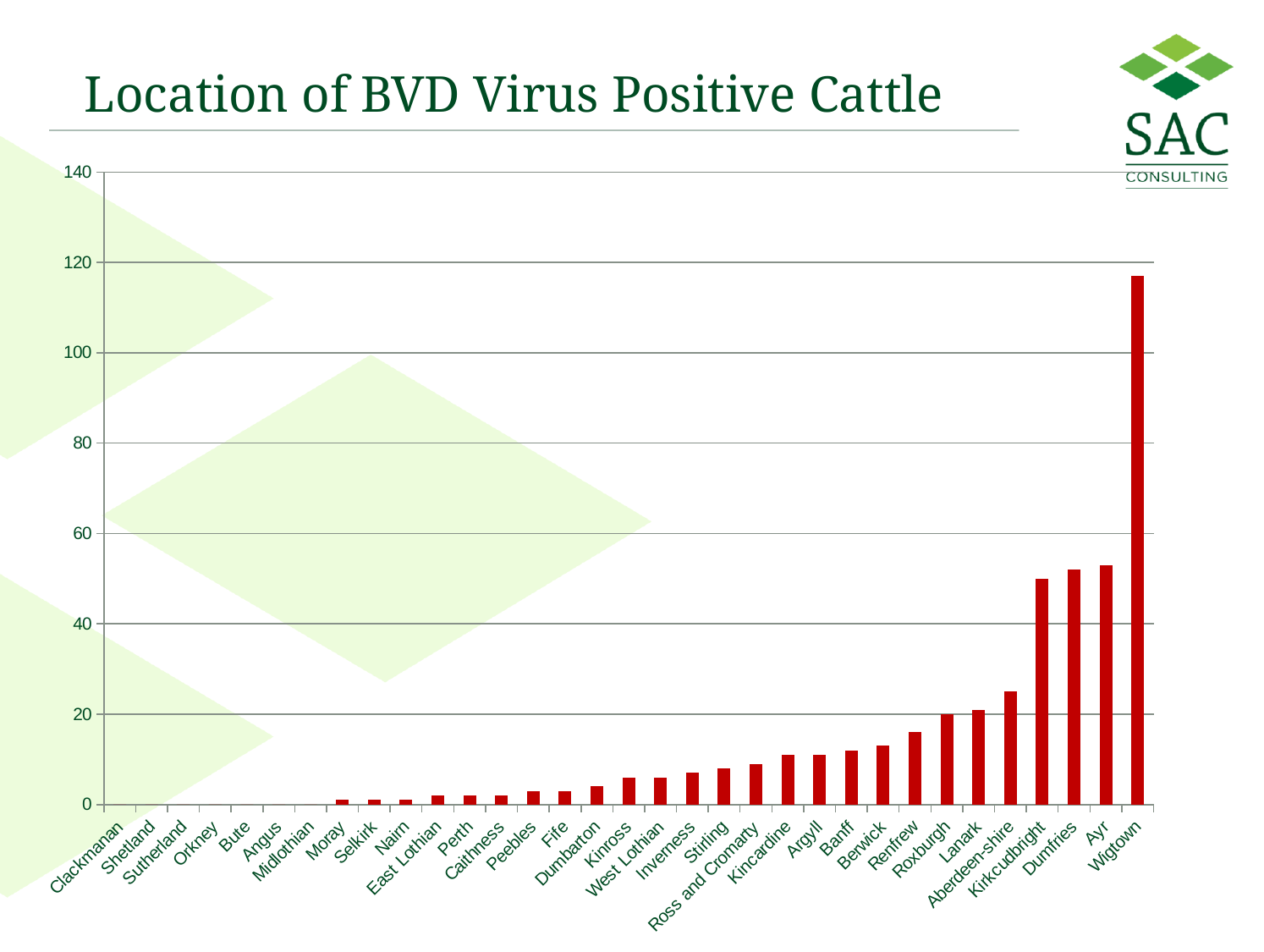
What is the title of the chart? Location of BVD Virus Positive Cattle Is the value for Wigtown greater or less than 100? greater Is the value for Renfrew greater or less than 20? less What kind of chart is shown on the slide? bar chart Which has a larger value, Wigtown or Ayr? Wigtown Which has a larger value, Dumfries or Aberdeen-shire? Dumfries Which location has the highest number of BVD virus positive cattle? Wigtown How many locations are shown on the x axis of the chart? 33 Do the values generally rise or fall moving from left to right along the x axis? rise Is the value for Ayr greater or less than 60? less